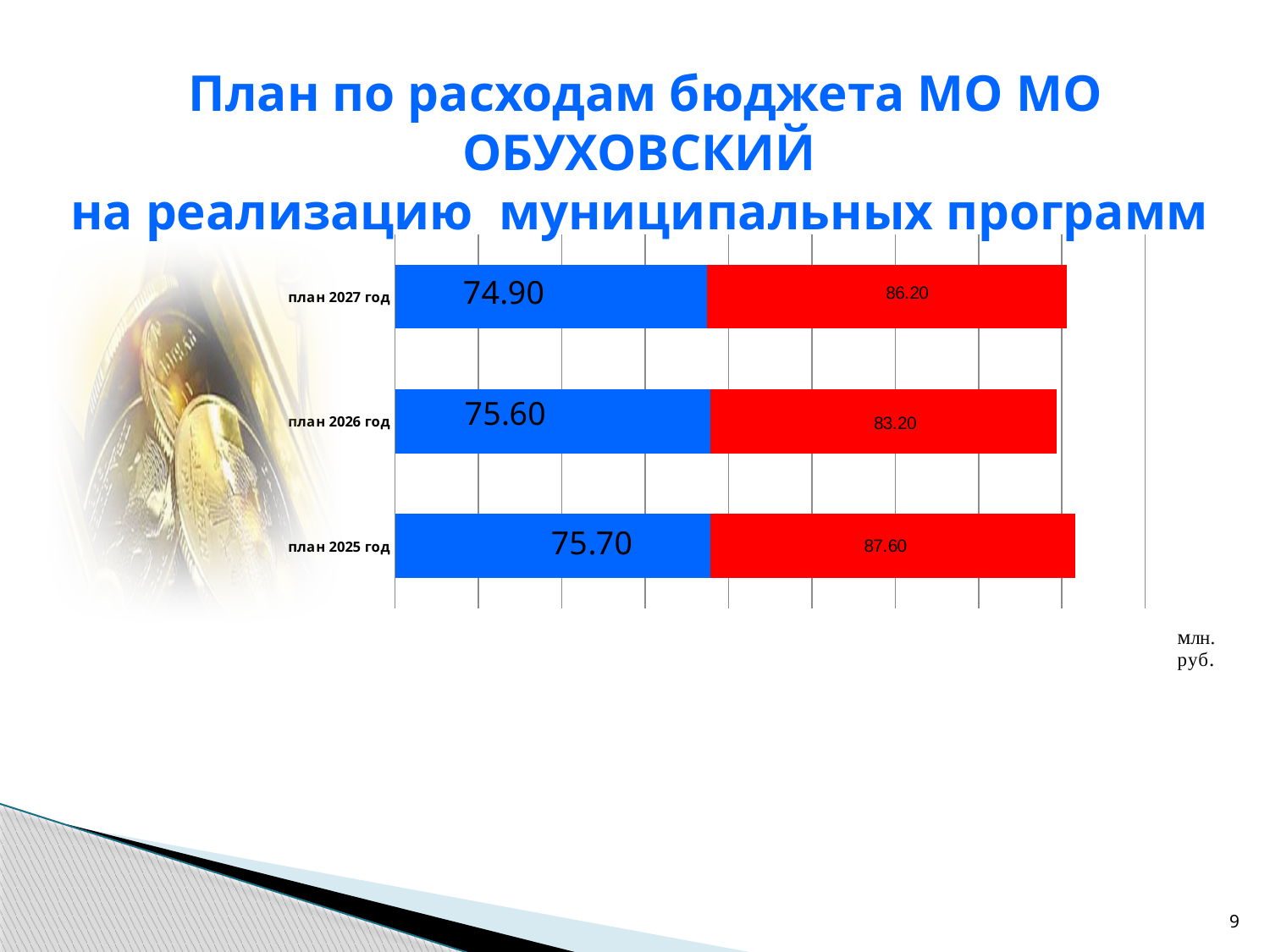
What unit is indicated for the values on the chart? млн. руб. What is the total of the stacked bar for план 2026 год? 158.80 What is the difference between the red segment values for план 2025 год and план 2026 год? 4.40 Which is larger: the red segment for план 2027 год or the red segment for план 2026 год? план 2027 год What is the value of the blue segment for план 2027 год? 74.90 Which plan year has the lowest blue segment value? план 2027 год What is the value of the red segment for план 2026 год? 83.20 How many categories (plan years) are shown on the chart? 3 What kind of chart is shown on the slide? bar chart What is the total of the stacked bar for план 2025 год? 163.30 Which plan year has the highest red segment value? план 2025 год What is the value of the red segment for план 2025 год? 87.60